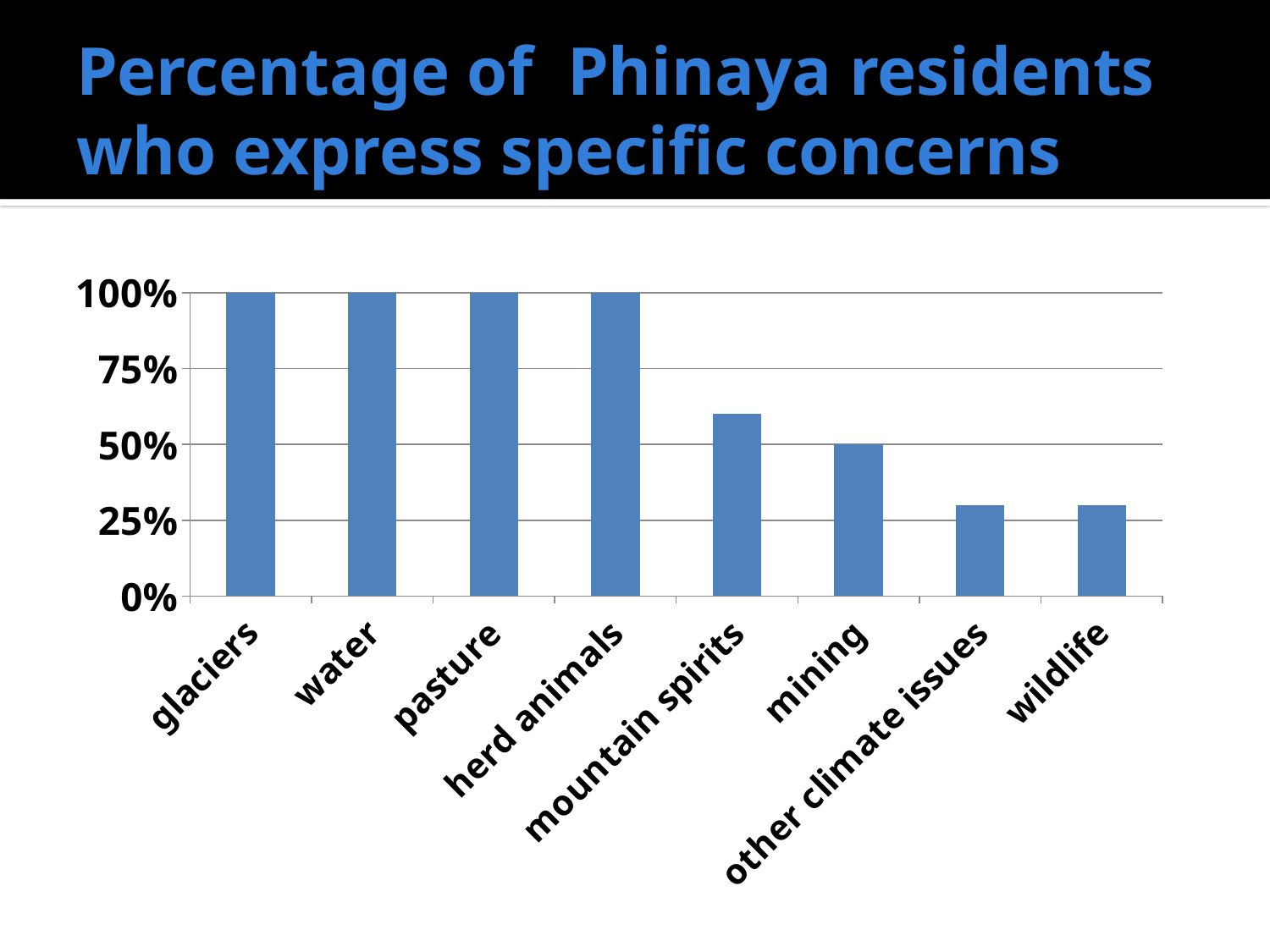
What is the value for mining? 50% Which is larger, the value for mining or the value for mountain spirits? mountain spirits Which is larger, the value for water or the value for wildlife? water What is the value for glaciers? 100% What is the difference between the value for glaciers and the value for mining? 50% Is the value for mountain spirits greater or less than 50%? greater Is the value for other climate issues greater or less than 25%? greater What kind of chart is shown on the slide? bar chart Do the values generally rise or fall moving from left to right along the x axis? fall Is the value for wildlife greater or less than 50%? less How many categories are shown on the x axis? 8 What is the value for herd animals? 100%